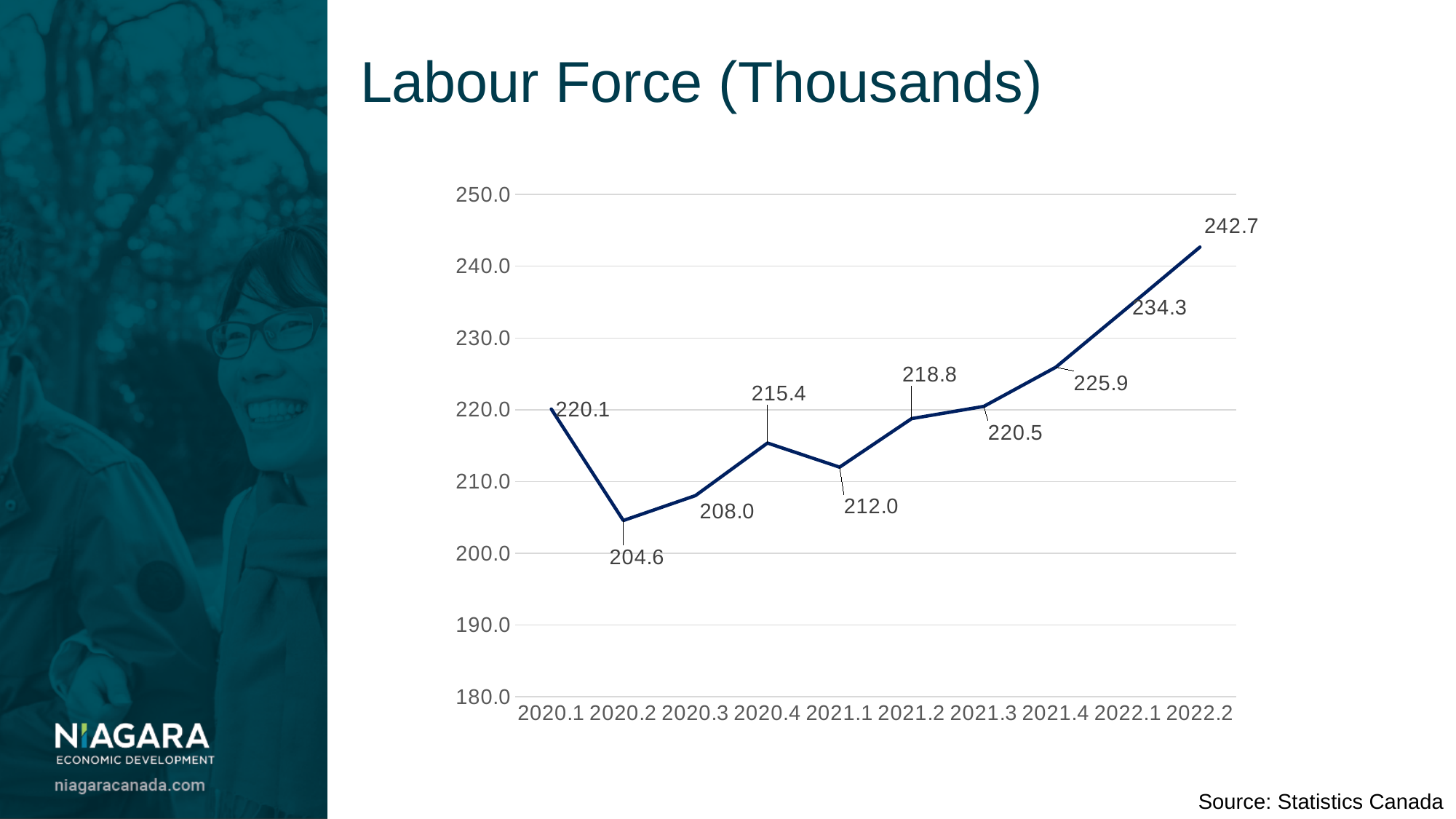
What is the title of the chart? Labour Force (Thousands) What is the difference between the labour force values for 2022.2 and 2020.2? 38.1 What kind of chart is shown on the slide? line chart What is the labour force value for 2020.1? 220.1 Do the labour force values rise or fall from 2021.1 to 2022.2? rise Is the value for 2022.1 greater or less than 230.0? greater Which is larger, the labour force value for 2020.4 or for 2021.1? 2020.4 What is the labour force value for 2022.2? 242.7 What is the labour force value for 2021.3? 220.5 How many periods are plotted on the x axis? 10 Which period has the highest labour force value? 2022.2 Which period has the lowest labour force value? 2020.2